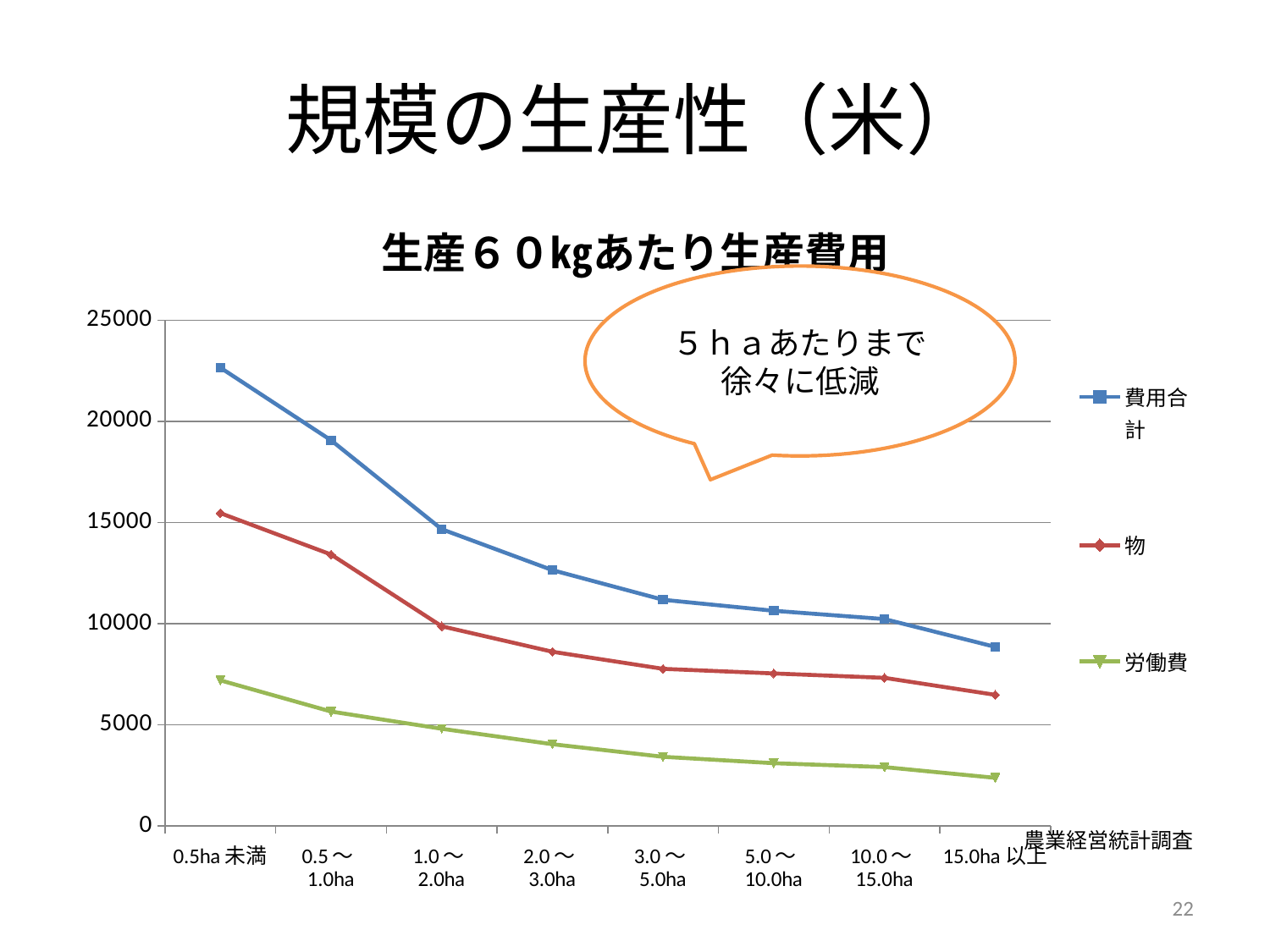
Which series is drawn in green? 労働費 Do the values for 費用合計 rise or fall as farm size increases along the x axis? fall How many series does the legend list? 3 How many farm-size categories are shown on the x axis? 8 For 1.0～2.0ha, which is larger: 費用合計 or 労働費? 費用合計 For which category is 労働費 lowest? 15.0ha 以上 Is the value of 費用合計 for 0.5ha 未満 greater or less than 20000? greater For which category is 費用合計 highest? 0.5ha 未満 Is the value of 労働費 for 15.0ha 以上 greater or less than 5000? less What kind of chart is shown on the slide? line chart Is the value of 費用合計 for 3.0～5.0ha greater or less than 10000? greater What is the title of the chart? 生産６０kgあたり生産費用